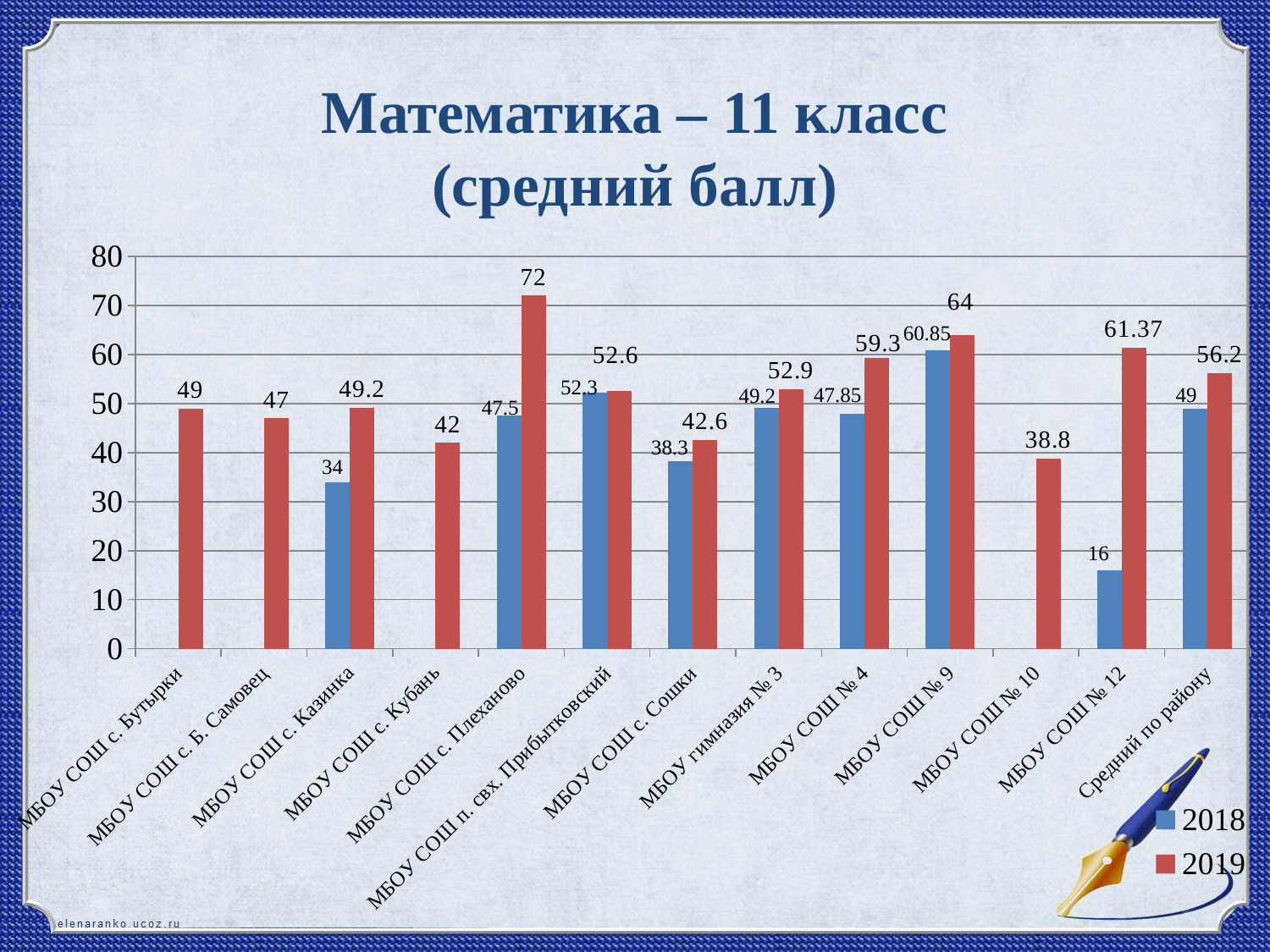
Which category has the lowest 2018 value? МБОУ СОШ № 12 How many categories are shown on the x axis? 13 Which is larger: the 2019 value for МБОУ СОШ с. Кубань or the 2019 value for МБОУ СОШ с. Бутырки? МБОУ СОШ с. Бутырки What is the 2019 value for Средний по району? 56.2 Which category has the highest 2019 value? МБОУ СОШ с. Плеханово What is the title of the chart? Математика – 11 класс (средний балл) What is the 2018 value for МБОУ СОШ № 12? 16 What is the 2019 value for МБОУ СОШ с. Плеханово? 72 What type of chart is shown on the slide? bar chart What is the difference between the 2019 and 2018 values for МБОУ СОШ № 4? 11.45 How many series does the legend list? 2 What is the 2018 value for МБОУ СОШ № 9? 60.85